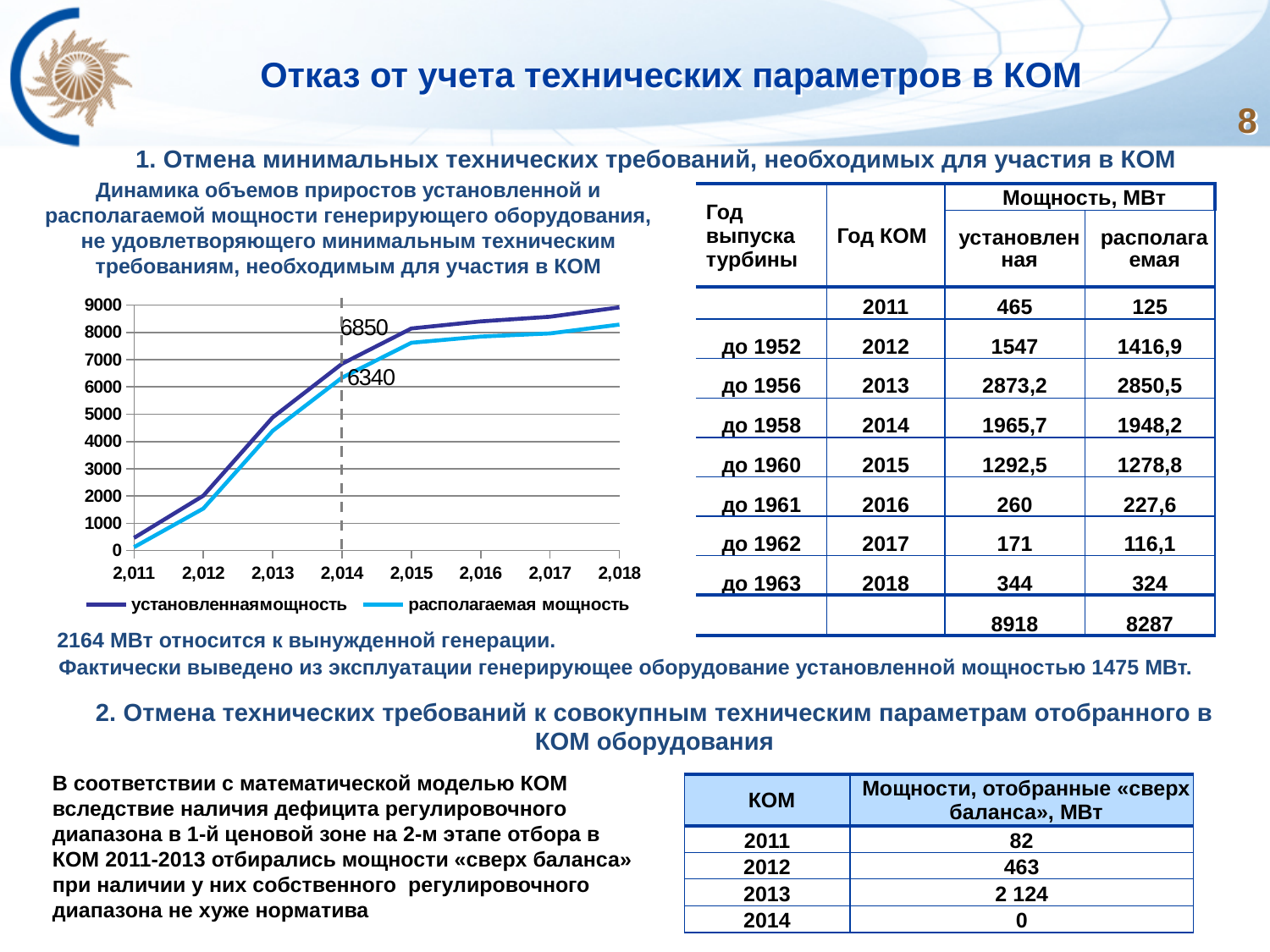
In which year does установленная мощность reach its highest value on the chart? 2018 Is the value of установленная мощность at 2011 greater or less than 1000? less At 2014, which series has the larger value: установленная мощность or располагаемая мощность? установленная мощность Which colour is used for the располагаемая мощность line in the chart? light blue Is the value of располагаемая мощность at 2018 greater or less than 8000? greater What is the difference between установленная мощность and располагаемая мощность at 2014 on the chart? 510 How many series does the chart legend list? 2 Do the values of установленная мощность rise or fall from 2011 to 2018? rise What kind of chart is shown on the slide? line chart How many years are plotted along the x axis of the chart? 8 What is the value of располагаемая мощность at 2014 on the chart? 6340 What is the value of установленная мощность at 2014 on the chart? 6850